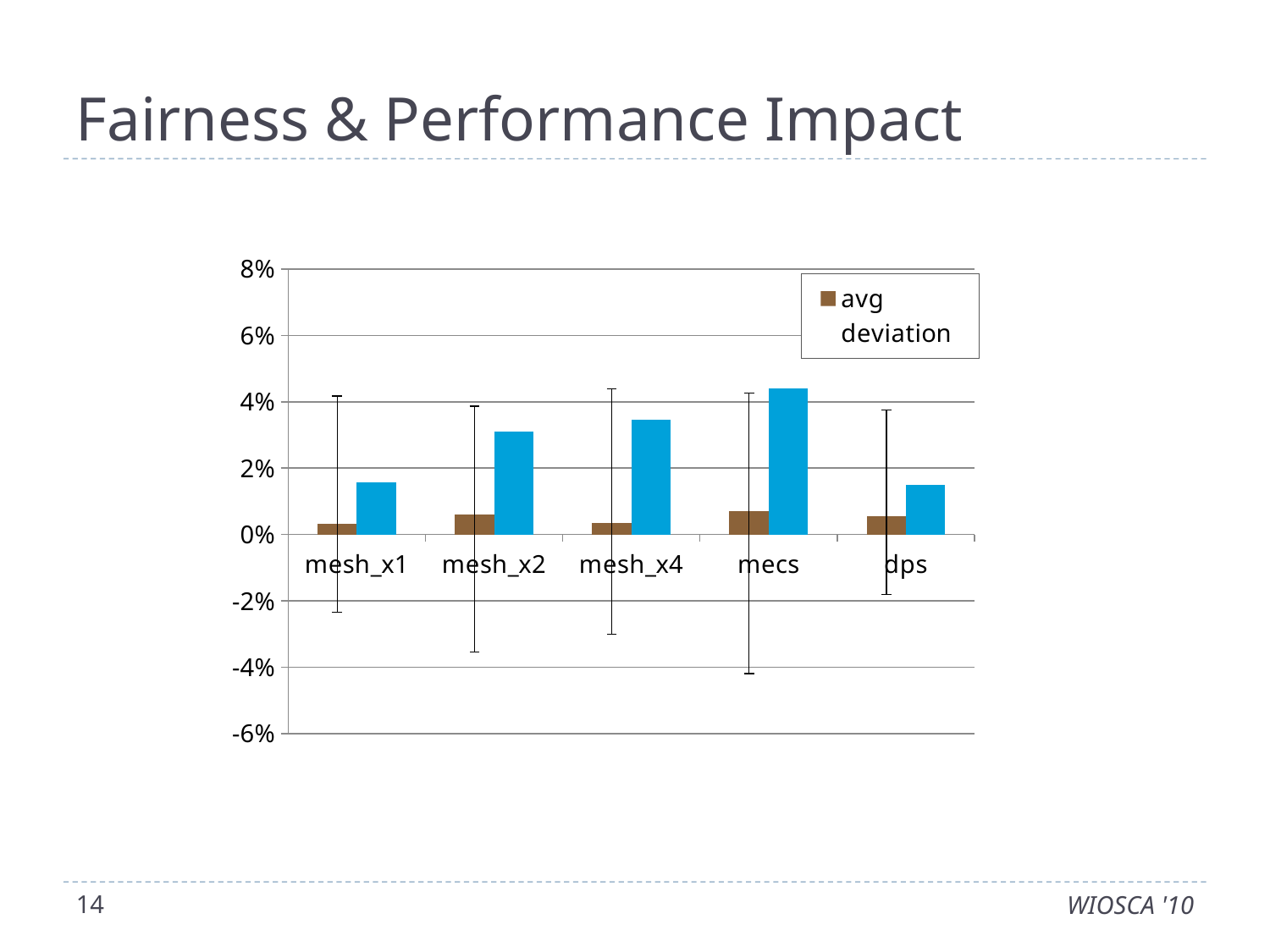
Which has the larger deviation value, mecs or mesh_x1? mecs Is the deviation value for mesh_x4 greater or less than 4%? less Is the deviation value for dps greater or less than 2%? less What kind of chart is shown on the slide? bar chart How many series does the chart's legend list? 1 Which category has the highest deviation value? mecs What is the title of the slide containing the chart? Fairness & Performance Impact Is the deviation value for mesh_x1 greater or less than 2%? less How many categories are shown on the x axis of the chart? 5